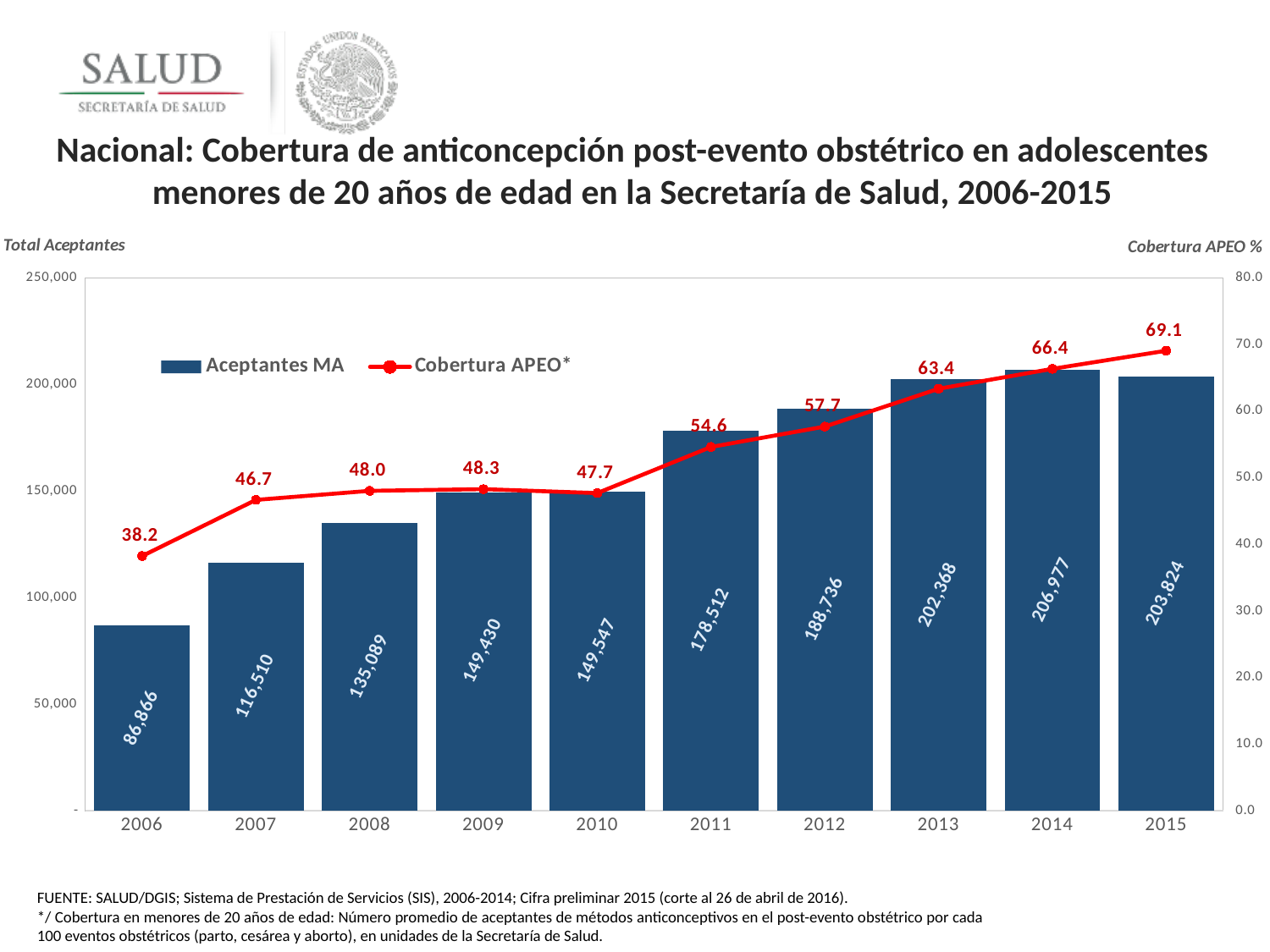
Which year has the lowest Cobertura APEO* value? 2006 What kind of chart is shown on the slide? Combined bar and line chart What is the value of Aceptantes MA for 2010? 149,547 What is the difference in Aceptantes MA between 2014 and 2013? 4,609 By how much did Cobertura APEO* increase from 2014 to 2015? 2.7 How many years are shown on the x axis of the chart? 10 What is the Cobertura APEO* value for 2013? 63.4 What colour is the Cobertura APEO* line? Red Which year has more Aceptantes MA, 2011 or 2012? 2012 Does the Cobertura APEO* line generally rise or fall from 2006 to 2015? Rise How many series does the legend list? 2 Which year has the highest number of Aceptantes MA? 2014